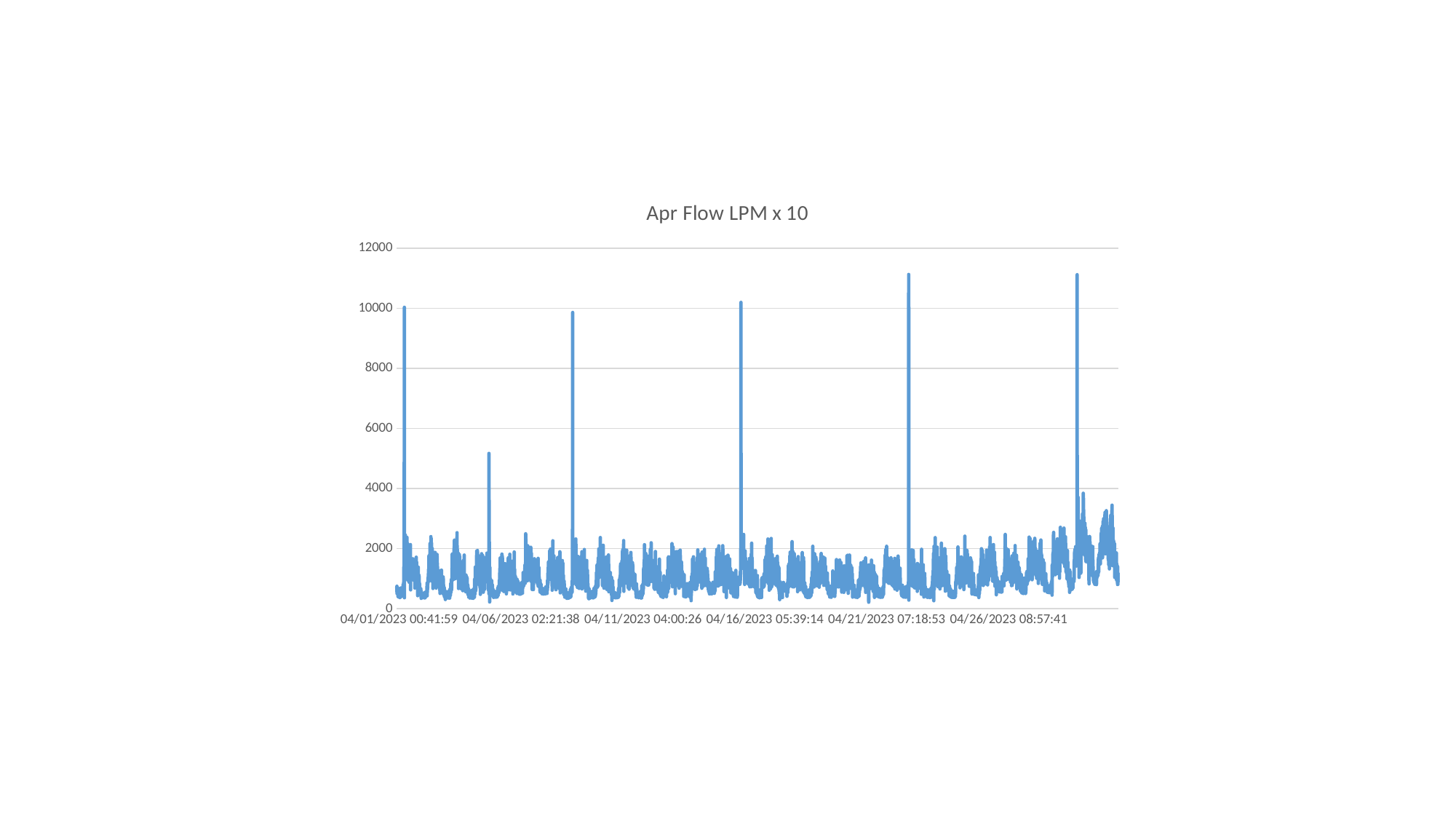
What is the highest value labelled on the y axis of the chart? 12000 What kind of chart is shown on the slide? Line chart How many date labels are shown along the x axis of the chart? 6 Is the small spike just before 04/06/2023 02:21:38 greater or less than 6000? less Is the highest spike in the chart greater or less than 10000? greater Is the small spike just before 04/06/2023 02:21:38 greater or less than 4000? greater Which is larger: the spike just after 04/21/2023 07:18:53 or the spike just before 04/06/2023 02:21:38? The spike just after 04/21/2023 07:18:53 How many spikes in the chart rise above 8000? 5 What is the title of the chart? Apr Flow LPM x 10 What is the first date label shown on the x axis of the chart? 04/01/2023 00:41:59